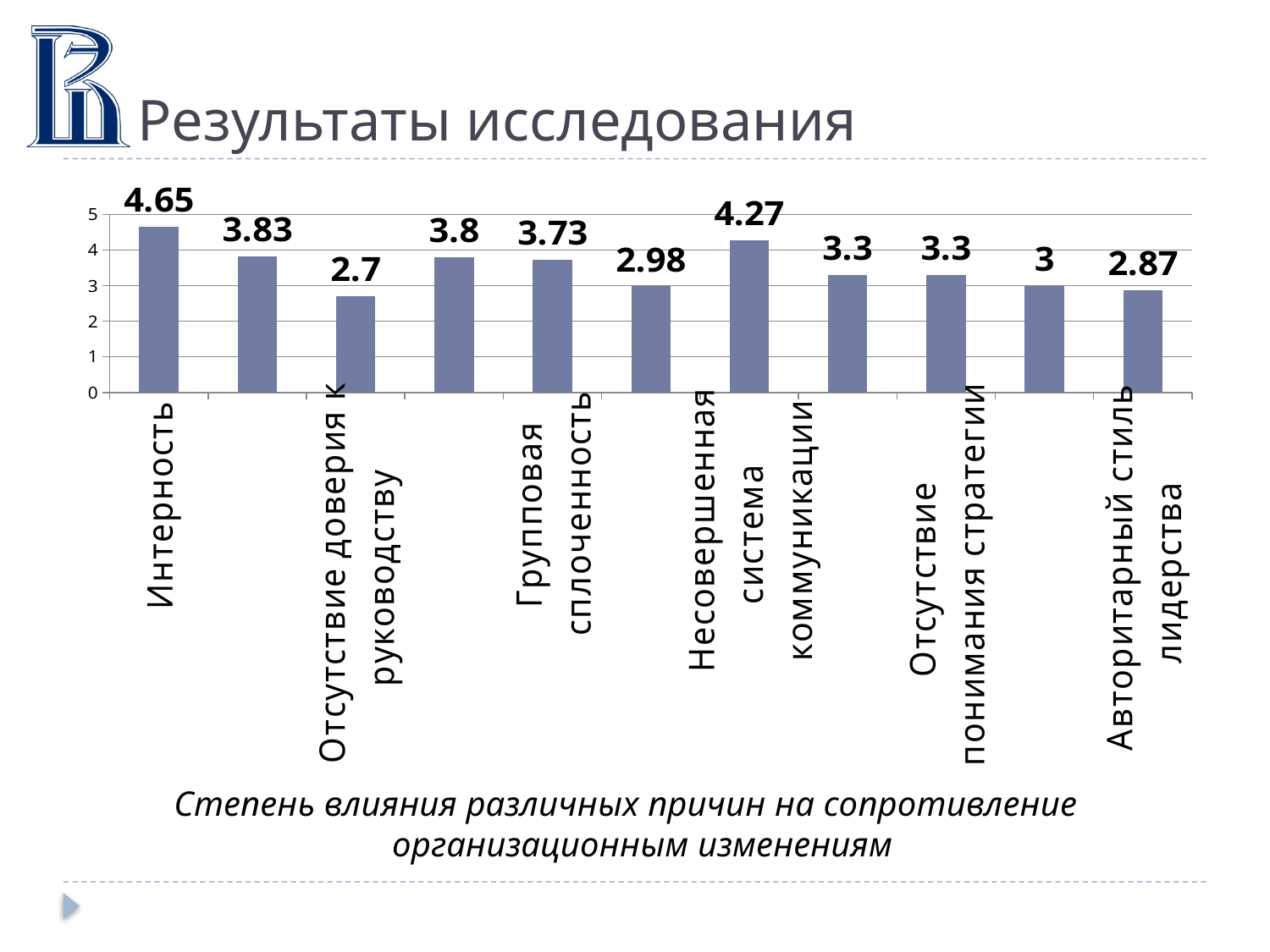
What is the caption printed below the chart? Степень влияния различных причин на сопротивление организационным изменениям What kind of chart is shown on the slide? Bar chart How many bars are plotted in the chart? 11 What is the value for Авторитарный стиль лидерства? 2.87 Which is larger, the value for Групповая сплоченность or the value for Отсутствие понимания стратегии? Групповая сплоченность What is the value for Интерность? 4.65 Which category has the highest value? Интерность What is the value for Отсутствие доверия к руководству? 2.7 Which category has the lowest value? Отсутствие доверия к руководству What is the difference between the values for Интерность and Несовершенная система коммуникации? 0.38 What is the value for Отсутствие понимания стратегии? 3.3 What is the value for Несовершенная система коммуникации? 4.27